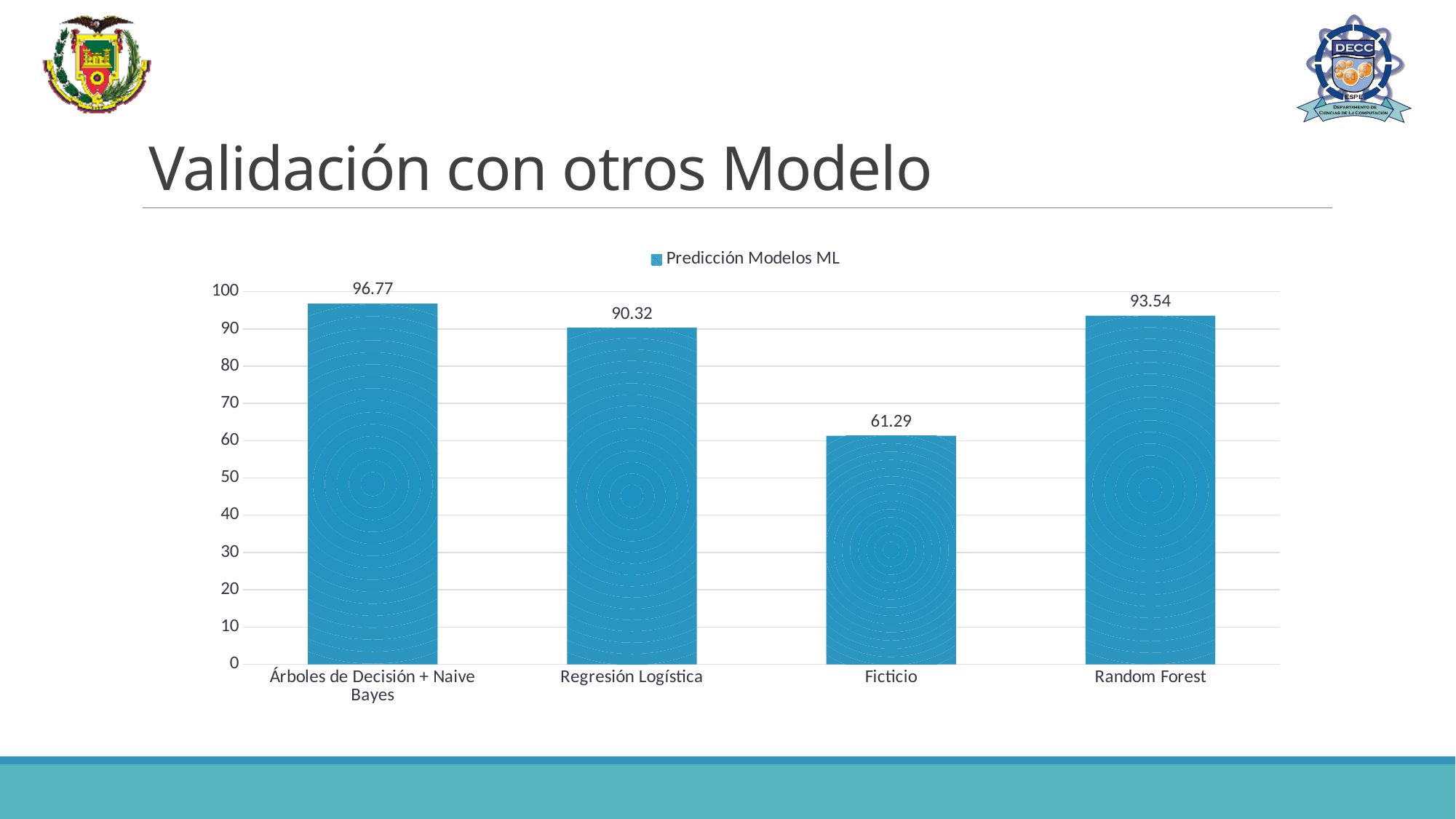
What is the difference between the values for Árboles de Decisión + Naive Bayes and Random Forest? 3.23 What is the value for Regresión Logística? 90.32 What series name does the legend show? Predicción Modelos ML What kind of chart is shown on the slide? bar chart Which is larger, the value for Random Forest or the value for Regresión Logística? Random Forest What is the value for Ficticio? 61.29 What is the difference between the values for Regresión Logística and Ficticio? 29.03 What is the value for Árboles de Decisión + Naive Bayes? 96.77 What is the value for Random Forest? 93.54 How many categories are shown on the x axis? 4 Which category has the lowest value? Ficticio Which category has the highest value? Árboles de Decisión + Naive Bayes